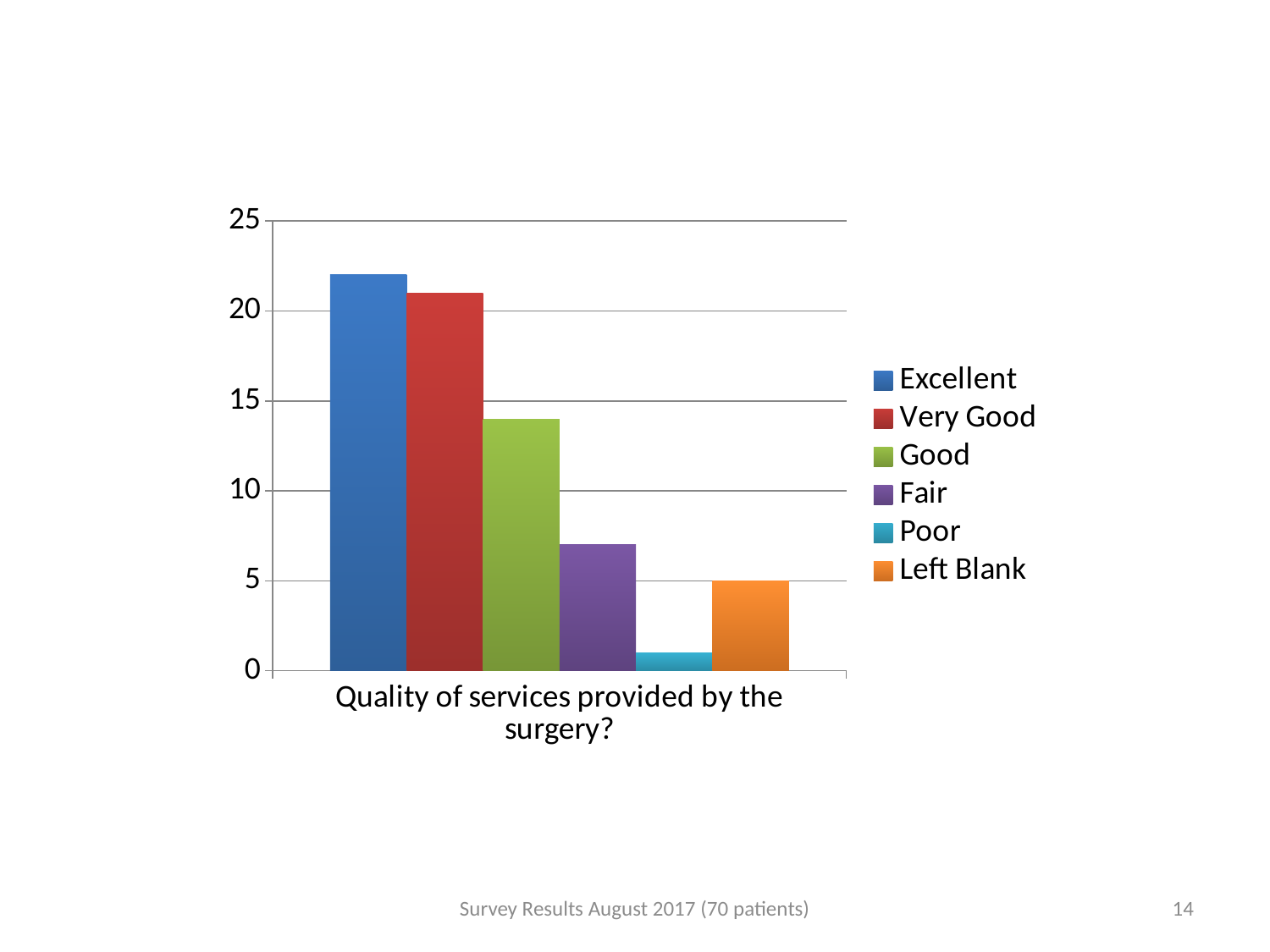
What is the value for Left Blank? 5 Is the value for Very Good greater or less than 20? greater Is the value for Excellent greater or less than 20? greater Which is larger, the value for Good or the value for Fair? Good Is the value for Good greater or less than 15? less How many series does the legend list? 6 What kind of chart is shown on the slide? bar chart Which response has the lowest value? Poor Which is larger, the value for Left Blank or the value for Poor? Left Blank What is the category label shown under the bars on the x axis? Quality of services provided by the surgery?